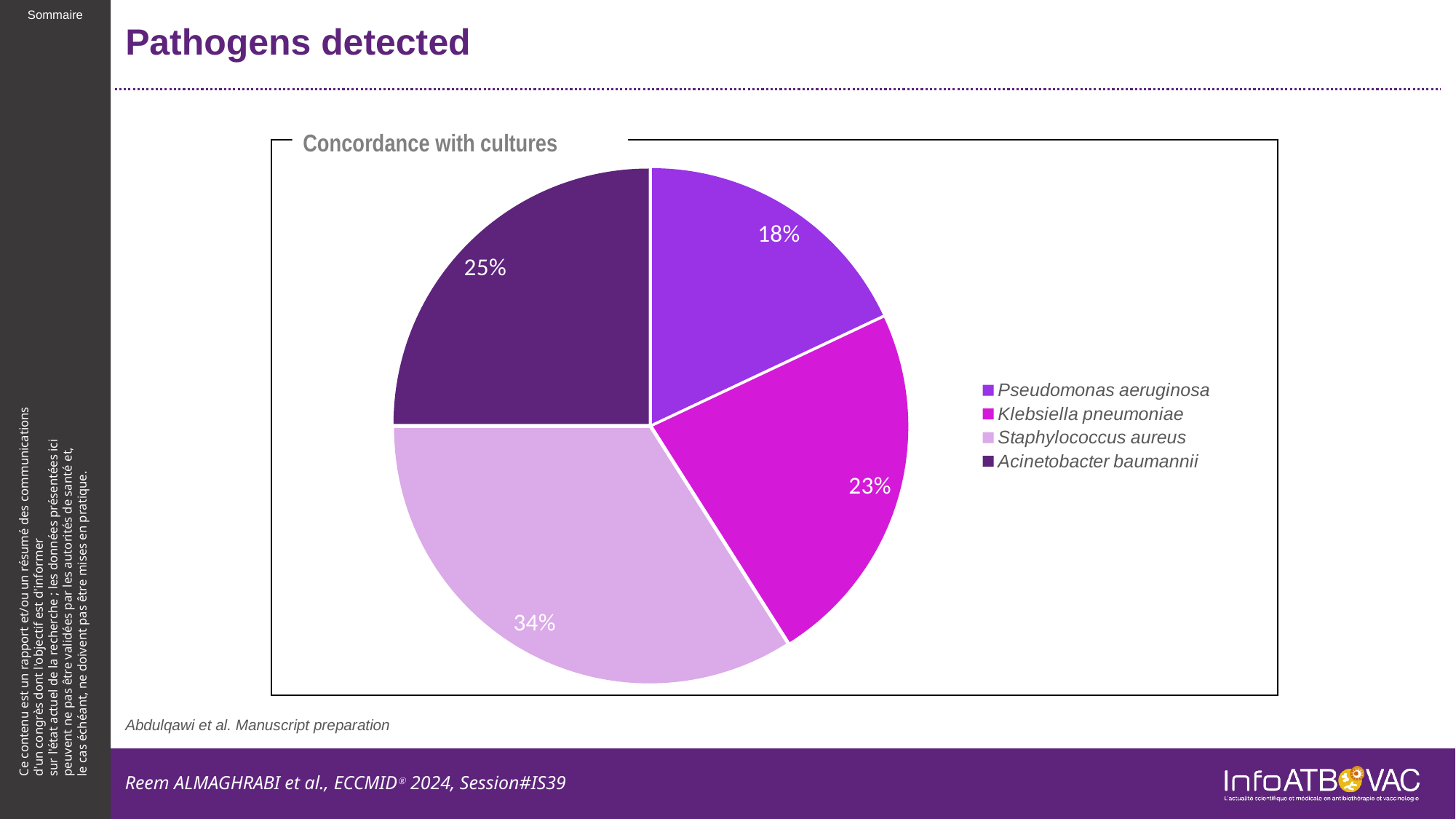
What is the difference in percentage points between Staphylococcus aureus and Pseudomonas aeruginosa? 16 What share of the pie is Staphylococcus aureus? 34% Which is larger, the share for Acinetobacter baumannii or the share for Klebsiella pneumoniae? Acinetobacter baumannii What is the chart's title? Concordance with cultures What kind of chart is shown on the slide? Pie chart Which pathogen is shown in the darkest purple slice? Acinetobacter baumannii What share of the pie is Acinetobacter baumannii? 25% Which pathogen has the smallest slice of the pie? Pseudomonas aeruginosa What share of the pie is Pseudomonas aeruginosa? 18% How many pathogens are shown in the pie chart? 4 Which pathogen has the largest slice of the pie? Staphylococcus aureus